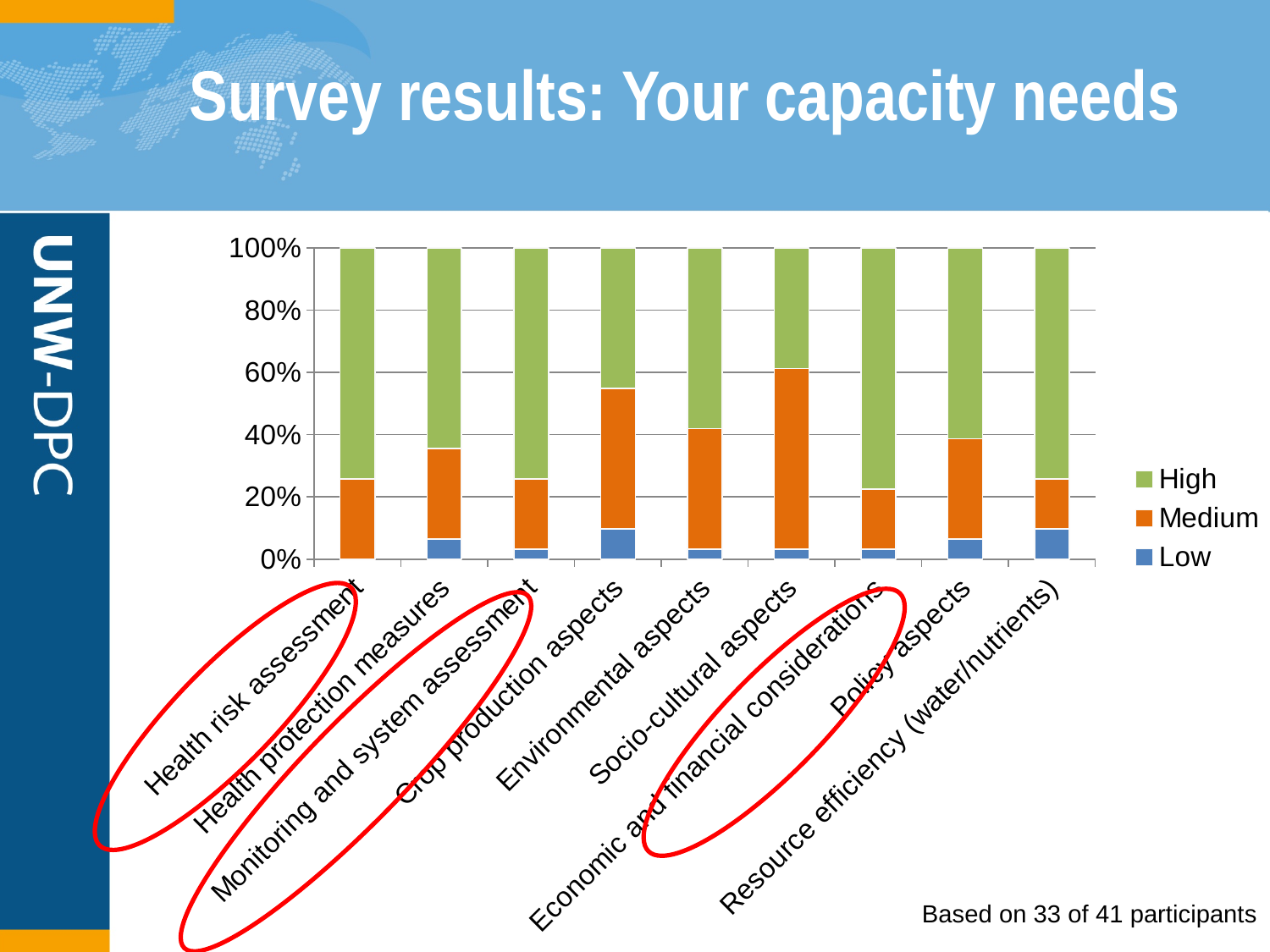
Is the High share for Socio-cultural aspects greater or less than 60%? less What kind of chart is shown on the slide? Stacked bar chart Which category has the largest Medium share? Socio-cultural aspects Is the combined Low and Medium share for Economic and financial considerations greater or less than 40%? less How many categories are plotted along the x axis? 9 Which category has the smallest High share? Socio-cultural aspects Is the combined Low and Medium share for Crop production aspects greater or less than 40%? greater How many series does the legend list? 3 What are the three series named in the legend? High, Medium, Low What does each stacked bar total? 100% What is the title of the slide containing the chart? Survey results: Your capacity needs Which has the larger High share, Crop production aspects or Environmental aspects? Environmental aspects